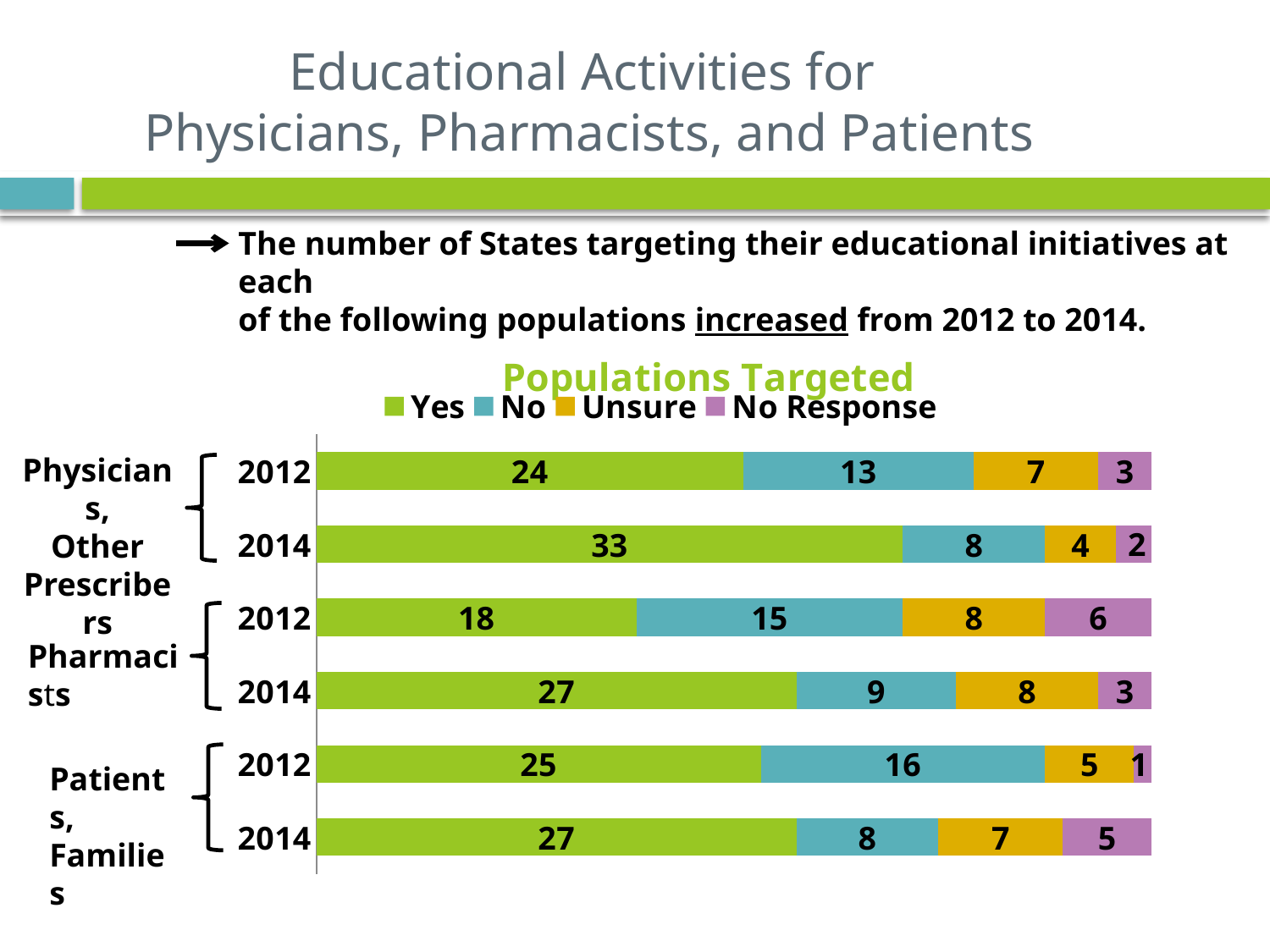
How many stacked bars are plotted in the "Populations Targeted" chart? 6 Which bar has the highest "Yes" value? Physicians, Other Prescribers 2014 By how much did the "Yes" value for Pharmacists increase from 2012 to 2014? 9 What kind of chart is shown under the title "Populations Targeted"? Stacked bar chart What is the "No" value for Pharmacists in 2012? 15 What is the "No Response" value for Patients, Families in 2012? 1 Which is larger: the "No" value for Patients, Families in 2012 or the "No" value for Physicians, Other Prescribers in 2012? Patients, Families 2012 What is the "Unsure" value for Patients, Families in 2014? 7 Which bar has the lowest "Yes" value? Pharmacists 2012 How many series does the legend of the "Populations Targeted" chart list? 4 What is the total of the stacked bar for Pharmacists in 2014? 47 What is the "Yes" value for Physicians, Other Prescribers in 2014? 33